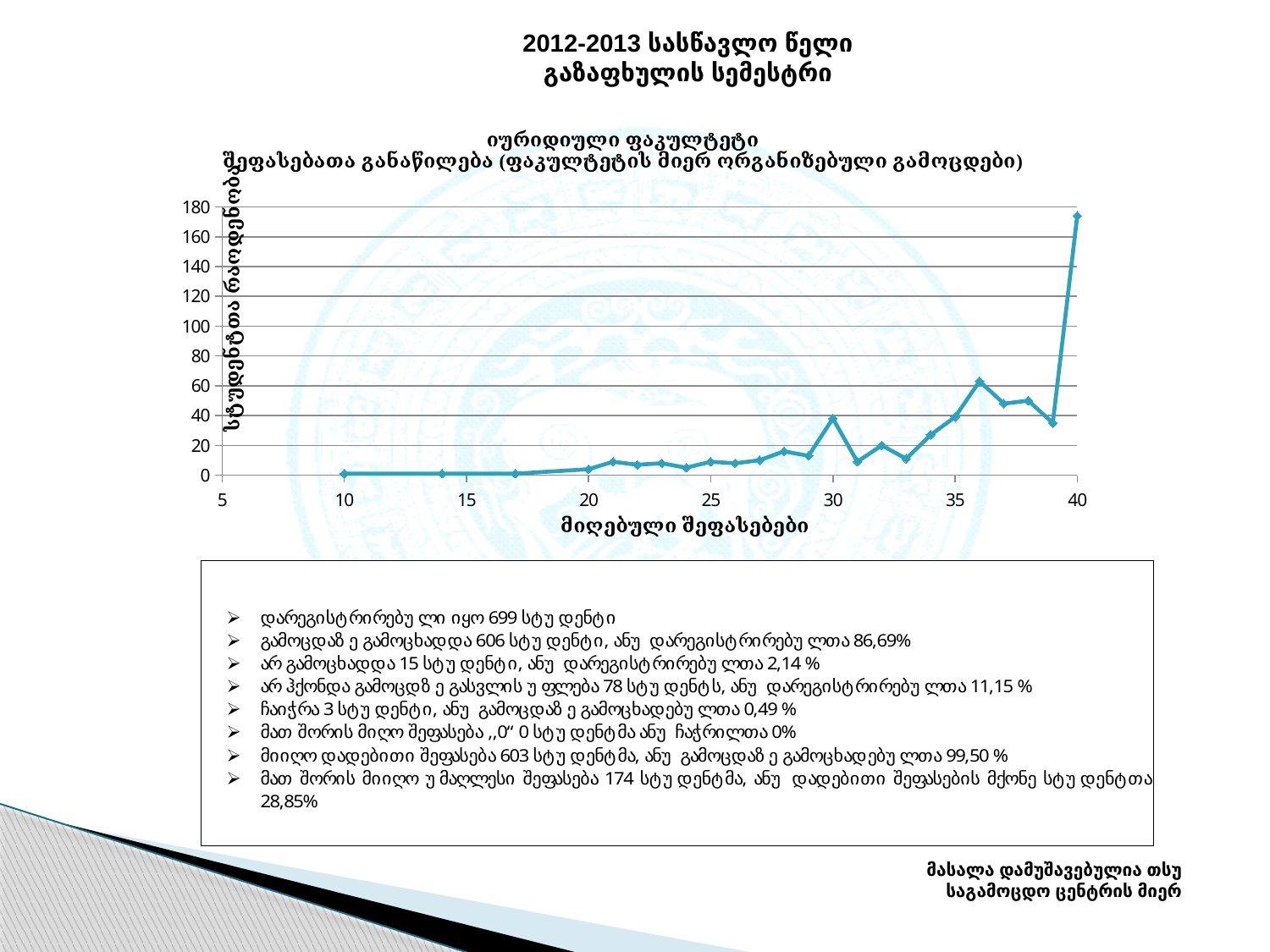
Is the number of students at grade 10 greater or less than 20? less Which has more students: grade 30 or grade 31? grade 30 Is the number of students at grade 30 greater or less than 20? greater What is the title of the x axis? მიღებული შეფასებები Does the number of students rise or fall between grade 39 and grade 40? rise What kind of chart is shown on the slide? line chart At which received grade (x-axis value) is the number of students highest? 40 Is the number of students at grade 36 greater or less than 40? greater Which has more students: grade 36 or grade 30? grade 36 What is the title of the y axis? სტუდენტთა რაოდენობა